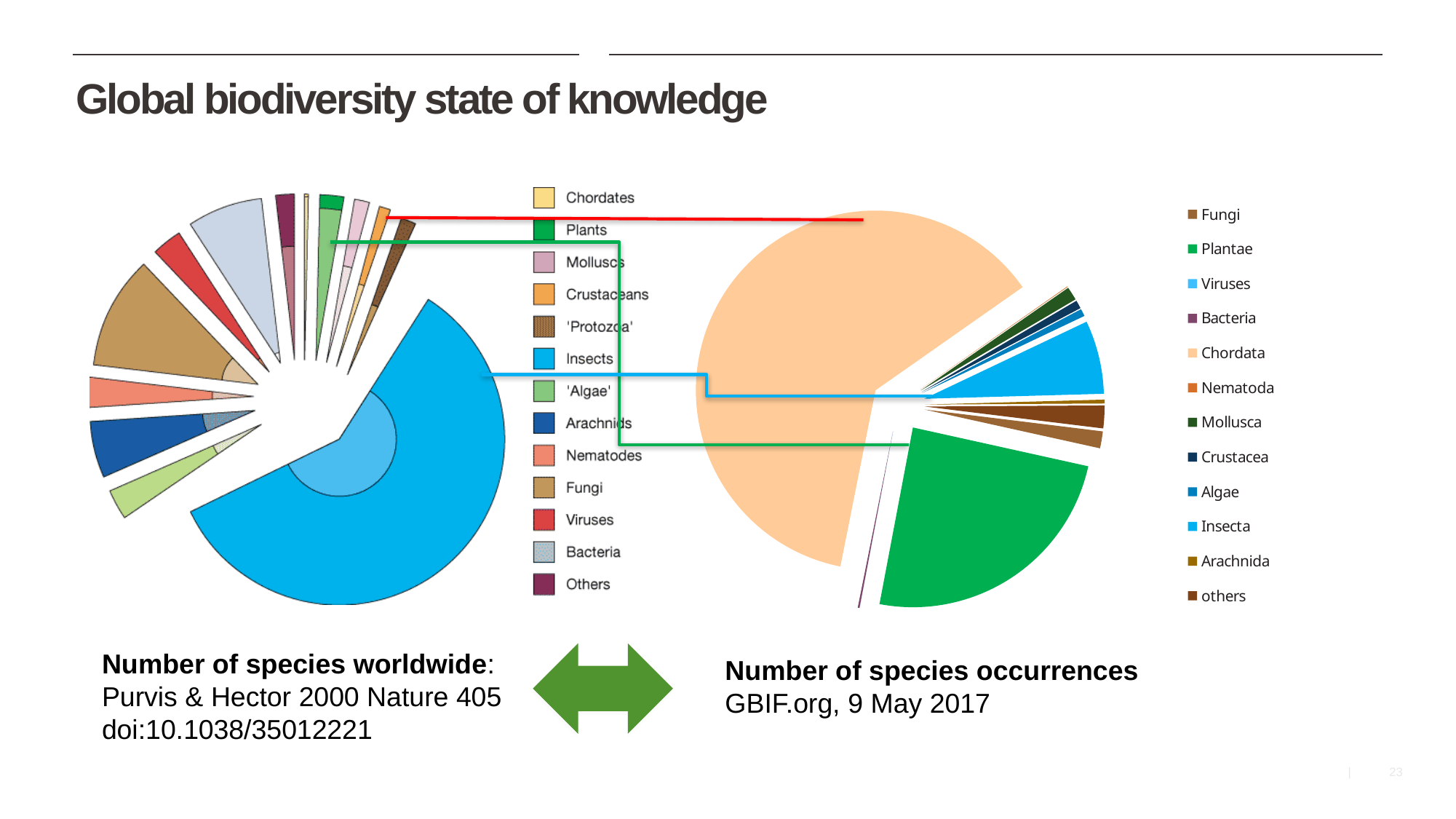
In the 'Number of species occurrences' chart on the right, which slice is larger, Plantae or Insecta? Plantae In the 'Number of species worldwide' chart on the left, which slice is larger, Insects or Fungi? Insects In the 'Number of species worldwide' chart on the left, which slice is larger, Fungi or Viruses? Fungi In the 'Number of species occurrences' chart on the right, which group has the largest slice? Chordata How many groups does the legend of the 'Number of species occurrences' chart on the right list? 12 In the 'Number of species worldwide' chart on the left, which group has the largest slice? Insects What kind of chart is the 'Number of species occurrences' chart on the right of the slide? pie chart In the 'Number of species occurrences' chart on the right, which group has the second largest slice? Plantae What is the source cited for the 'Number of species occurrences' chart on the right? GBIF.org, 9 May 2017 How many groups does the legend of the 'Number of species worldwide' chart on the left list? 13 What colour is the Chordata slice in the 'Number of species occurrences' chart on the right? light orange